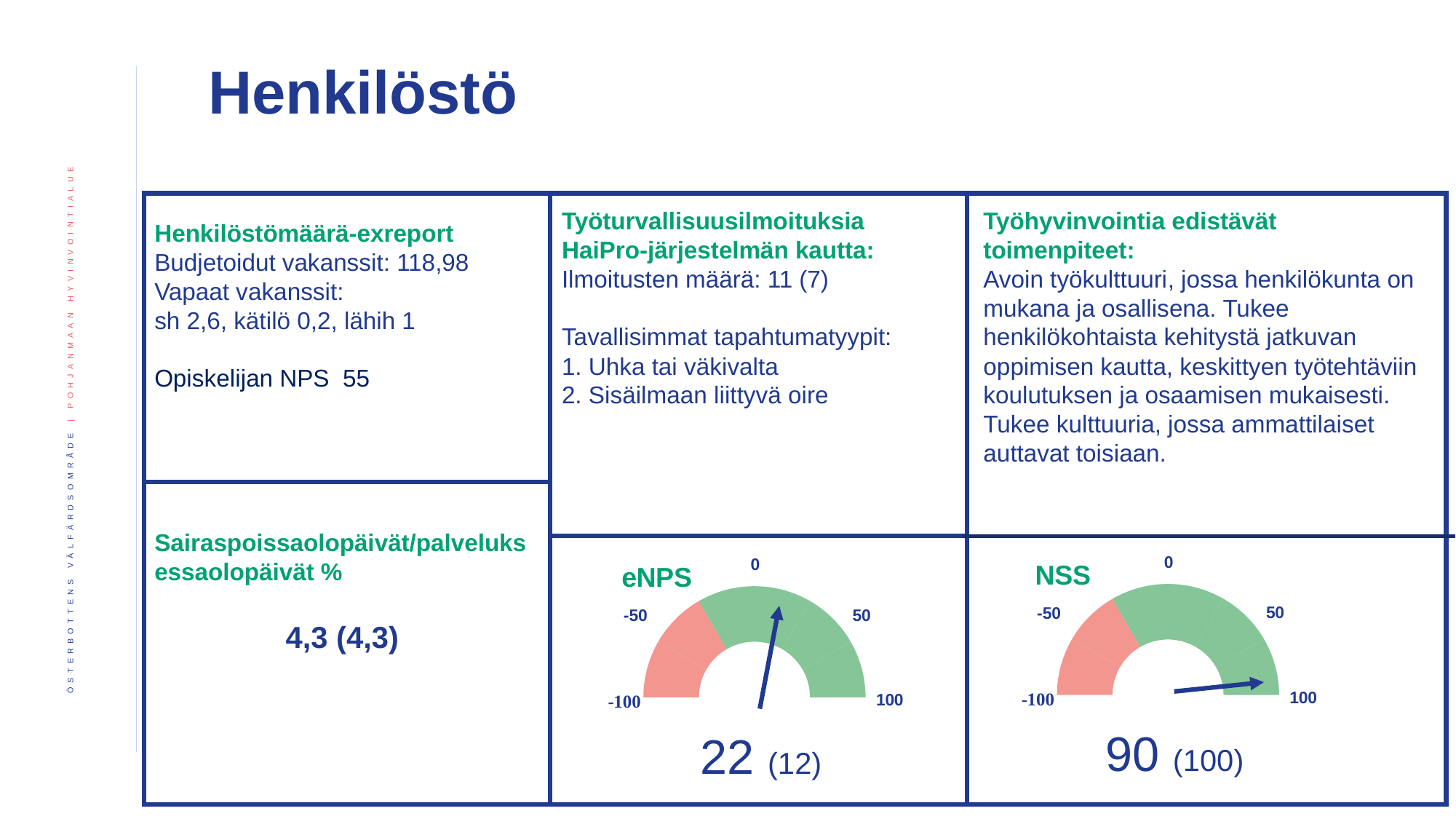
On the eNPS gauge chart, is the needle pointing into the green or the red section of the gauge? green On the NSS gauge chart, what is the current NSS value shown? 90 On the NSS gauge chart, is the needle value greater or less than 50? greater On the eNPS gauge chart, what is the value shown in parentheses next to the main value? 12 On the eNPS gauge chart, what is the current eNPS value shown? 22 What kind of chart is used to display the eNPS value? gauge chart On the eNPS gauge chart, is the needle value greater or less than 50? less On the eNPS gauge chart, what are the minimum and maximum values marked on the scale? -100 and 100 On the NSS gauge chart, what is the value shown in parentheses next to the main value? 100 Which is larger, the eNPS value on the eNPS gauge or the NSS value on the NSS gauge? NSS On the NSS gauge chart, what colour is the section of the scale between -100 and -50? red What is the difference between the NSS value (90) and the eNPS value (22) shown on the two gauge charts? 68